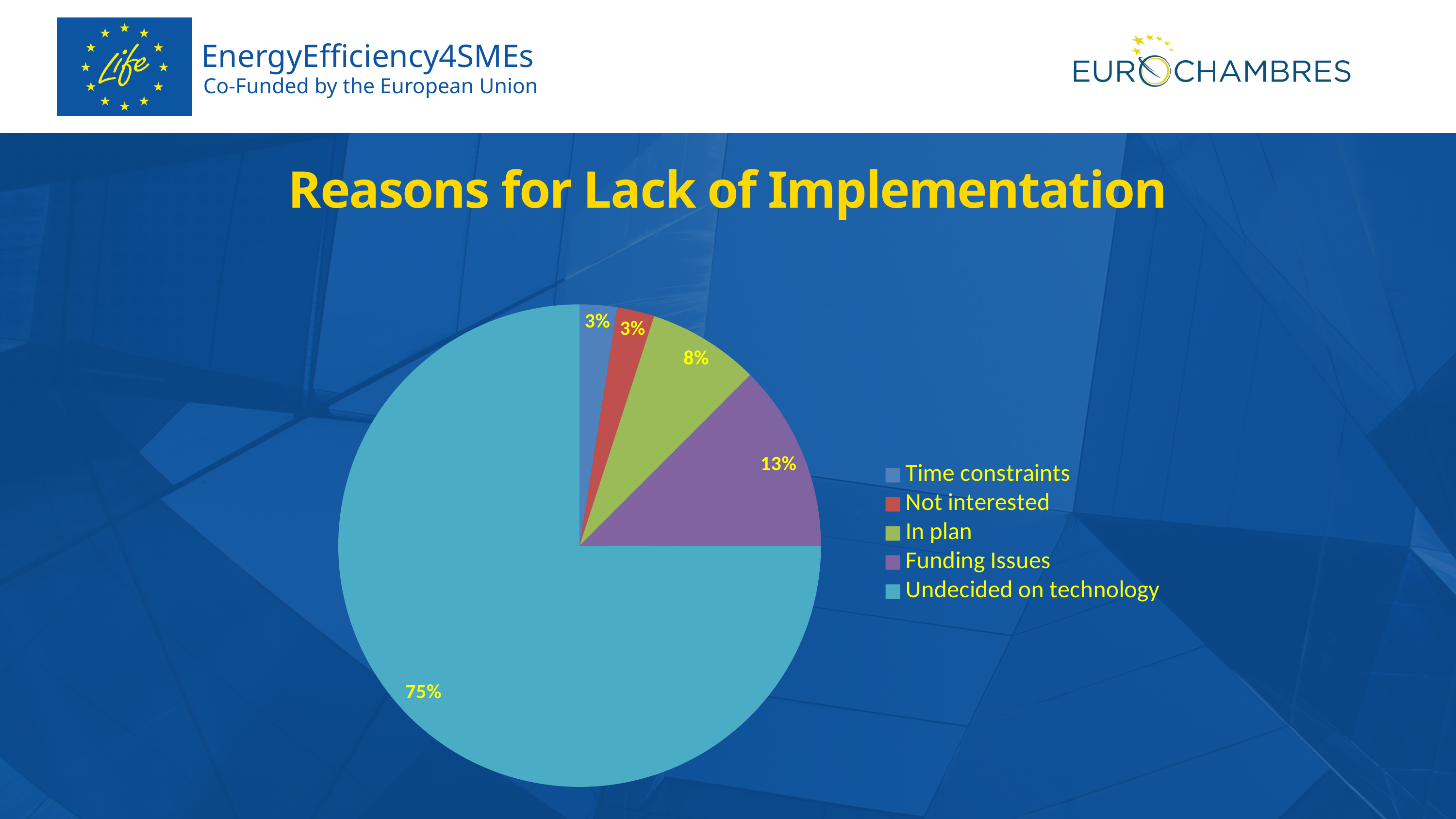
What share of the pie is labelled for In plan? 8% Which category has the largest slice of the pie? Undecided on technology What is the difference between the shares for Funding Issues and In plan? 5% Which category is shown in purple in the legend? Funding Issues What is the difference between the shares for Undecided on technology and Funding Issues? 62% What share of the pie is labelled for Not interested? 3% What share of the pie is labelled for Funding Issues? 13% What is the title of the chart? Reasons for Lack of Implementation Which is larger, the share for In plan or the share for Funding Issues? Funding Issues What type of chart is shown on the slide? pie chart How many categories does the legend list? 5